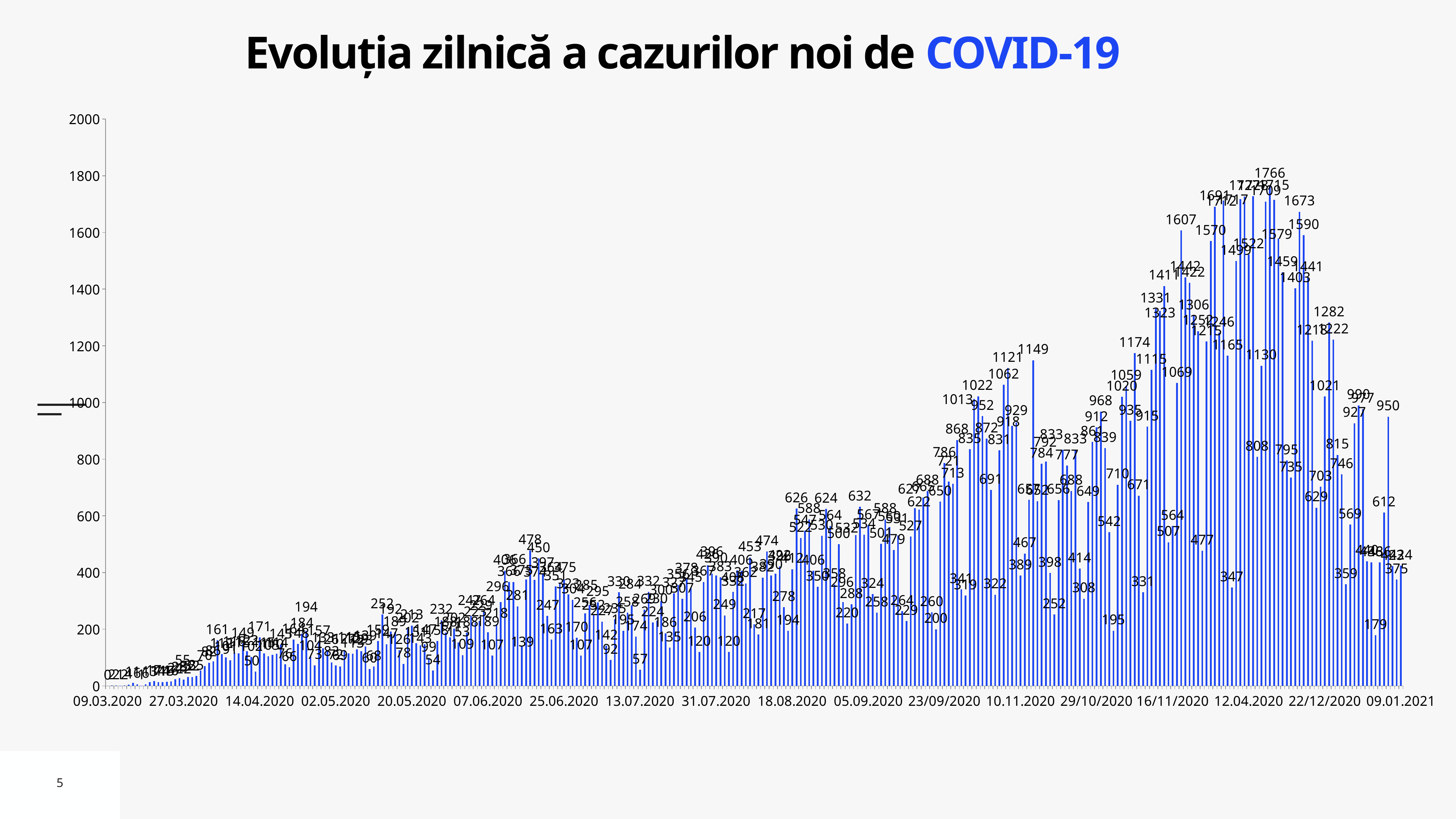
Which is larger, the bar labeled 1766 or the bar labeled 1607? 1766 What is the last date label on the horizontal axis? 09.01.2021 Do the daily values generally rise or fall from 09.03.2020 to 16/11/2020? rise What is the difference between the highest labeled value, 1766, and the bar labeled 1673? 93 What kind of chart is shown on the slide? bar chart Is the highest bar on the chart greater or less than 1600? greater What is the title of the chart? Evoluția zilnică a cazurilor noi de COVID-19 What is the highest value labeled between 07.06.2020 and 25.06.2020? 478 Is the highest bar on the chart greater or less than 1800? less What is the maximum value shown on the vertical axis? 2000 What is the first date label on the horizontal axis? 09.03.2020 What is the highest daily value labeled on the chart? 1766